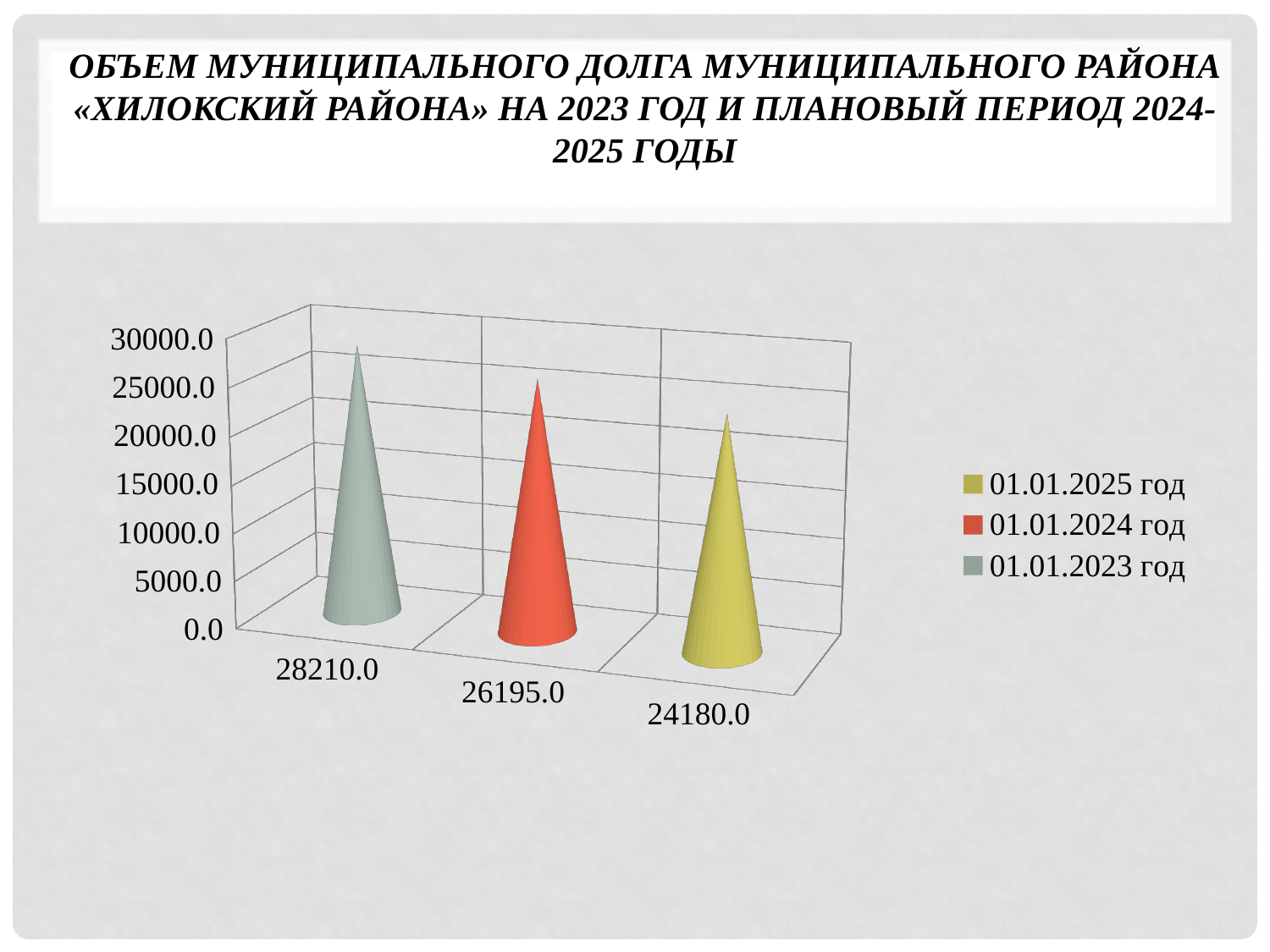
What is the value for 01.01.2023 год? 28210.0 What is the difference between the values for 01.01.2023 год and 01.01.2024 год? 2015.0 Which date has the highest municipal debt value? 01.01.2023 год What is the value for 01.01.2024 год? 26195.0 How many series does the legend list? 3 What is the difference between the values for 01.01.2023 год and 01.01.2025 год? 4030.0 Is the value for 01.01.2025 год greater or less than 25000.0? less What kind of chart is shown on the slide? bar chart What is the value for 01.01.2025 год? 24180.0 Which date has the lowest municipal debt value? 01.01.2025 год Which is larger, the value for 01.01.2024 год or 01.01.2025 год? 01.01.2024 год Do the values rise or fall from 01.01.2023 год to 01.01.2025 год? fall